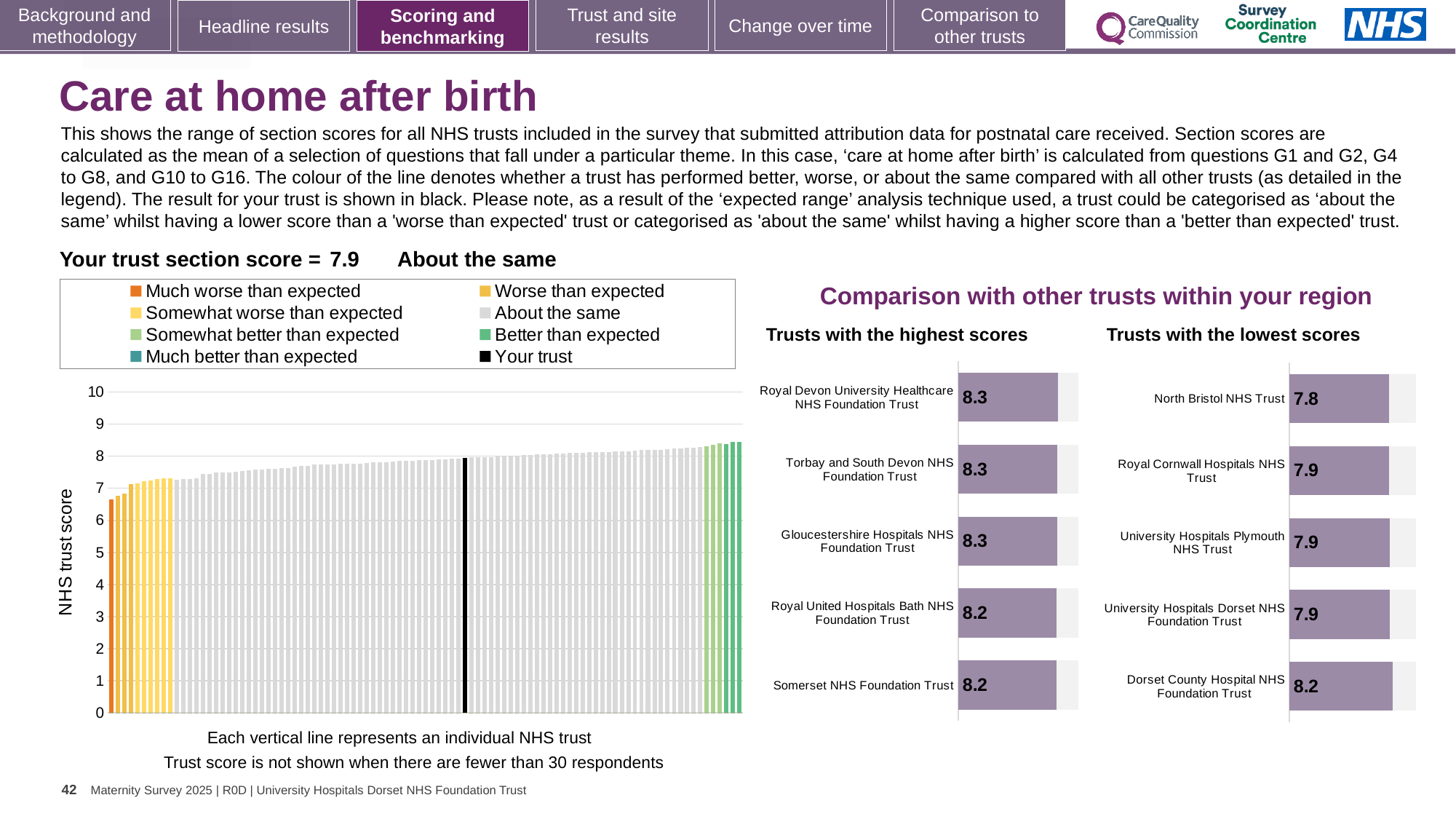
In the 'Trusts with the highest scores' chart, which has the larger score: Royal Devon University Healthcare NHS Foundation Trust or Somerset NHS Foundation Trust? Royal Devon University Healthcare NHS Foundation Trust In the 'Trusts with the lowest scores' chart, which trust has the lowest score? North Bristol NHS Trust In the NHS trust score chart, do the values rise or fall from left to right? Rise What kind of chart is the NHS trust score chart on the left of the slide? Bar chart In the NHS trust score chart, is the value of the leftmost bar greater or less than 6? greater In the 'Trusts with the lowest scores' chart, what is the difference between the scores of Dorset County Hospital NHS Foundation Trust and North Bristol NHS Trust? 0.4 In the 'Trusts with the lowest scores' chart, which trust has the highest score? Dorset County Hospital NHS Foundation Trust In the 'Trusts with the highest scores' chart, what is the score for Royal Devon University Healthcare NHS Foundation Trust? 8.3 How many entries does the legend of the NHS trust score chart list? 8 In the 'Trusts with the highest scores' chart, what is the score for Somerset NHS Foundation Trust? 8.2 In the 'Trusts with the lowest scores' chart, what is the score for North Bristol NHS Trust? 7.8 How many trusts are shown in the 'Trusts with the lowest scores' chart? 5